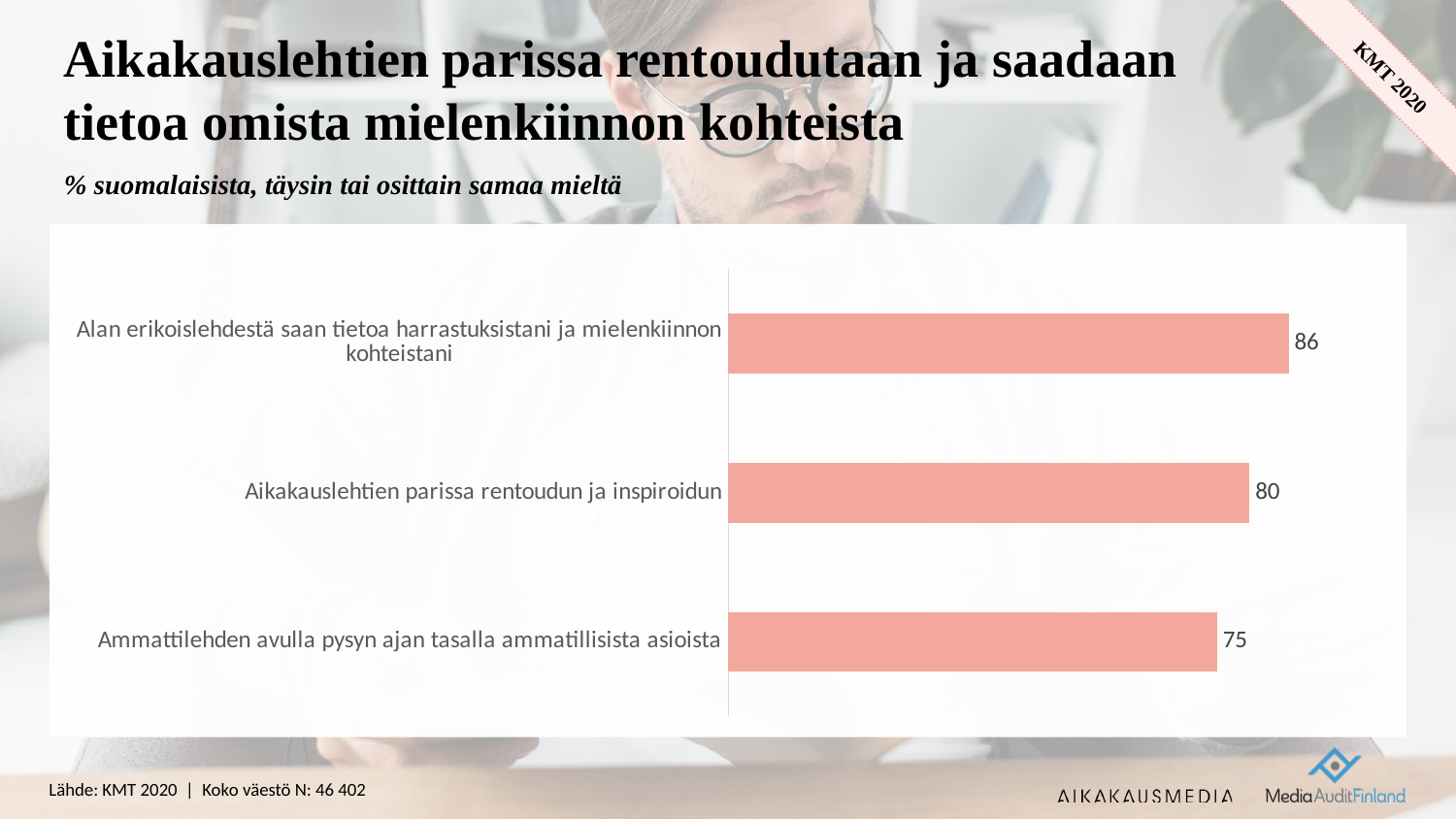
What is the value for "Ammattilehden avulla pysyn ajan tasalla ammatillisista asioista"? 75 Which category has the lowest value? Ammattilehden avulla pysyn ajan tasalla ammatillisista asioista What is the source and sample size given at the bottom of the slide? Lähde: KMT 2020 | Koko väestö N: 46 402 What kind of chart is shown on the slide? Bar chart What is the value for "Aikakauslehtien parissa rentoudun ja inspiroidun"? 80 What is the subtitle describing the unit of the chart values? % suomalaisista, täysin tai osittain samaa mieltä What is the value for "Alan erikoislehdestä saan tietoa harrastuksistani ja mielenkiinnon kohteistani"? 86 How many categories are shown in the chart? 3 Which category has the highest value? Alan erikoislehdestä saan tietoa harrastuksistani ja mielenkiinnon kohteistani What is the difference between the values for "Alan erikoislehdestä saan tietoa harrastuksistani ja mielenkiinnon kohteistani" and "Ammattilehden avulla pysyn ajan tasalla ammatillisista asioista"? 11 What is the difference between the values for "Aikakauslehtien parissa rentoudun ja inspiroidun" and "Ammattilehden avulla pysyn ajan tasalla ammatillisista asioista"? 5 Which is larger: the value for "Aikakauslehtien parissa rentoudun ja inspiroidun" or for "Ammattilehden avulla pysyn ajan tasalla ammatillisista asioista"? Aikakauslehtien parissa rentoudun ja inspiroidun